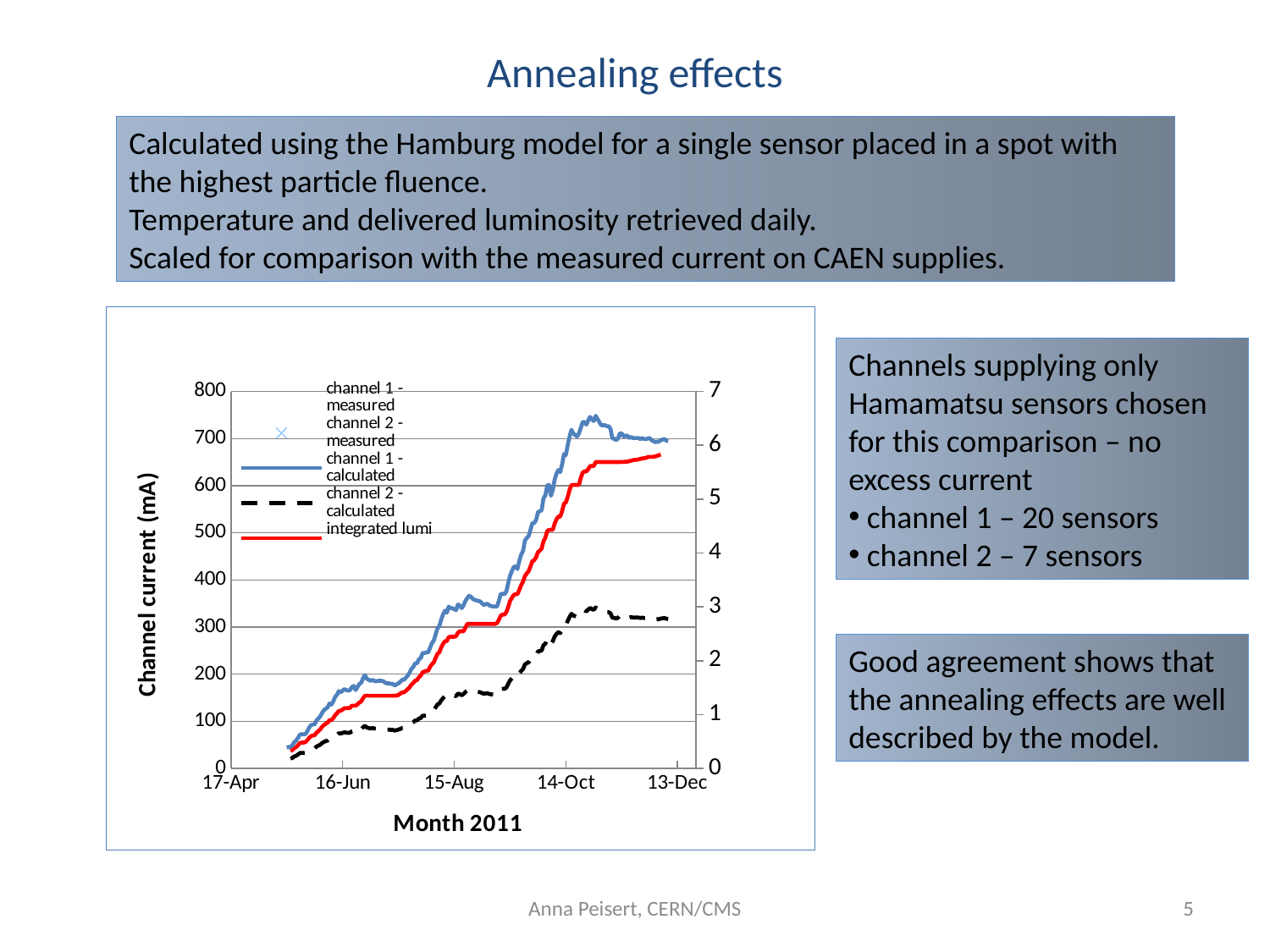
What is the label of the horizontal axis of the chart? Month 2011 Which series reaches the highest value on the chart? channel 1 - calculated At 13-Dec, which is larger: channel 1 - calculated or channel 2 - calculated? channel 1 - calculated Is the integrated lumi value at 13-Dec, read on the right axis, greater or less than 5? greater What is the label of the left vertical axis of the chart? Channel current (mA) Does the channel 1 - calculated line rise or fall overall from 17-Apr to 13-Dec? rise Is the value of channel 2 - calculated at 13-Dec greater or less than 200 mA? greater Is the value of channel 1 - calculated at 13-Dec greater or less than 600 mA? greater How many series does the chart legend list? 5 What kind of chart is shown on the slide? line chart